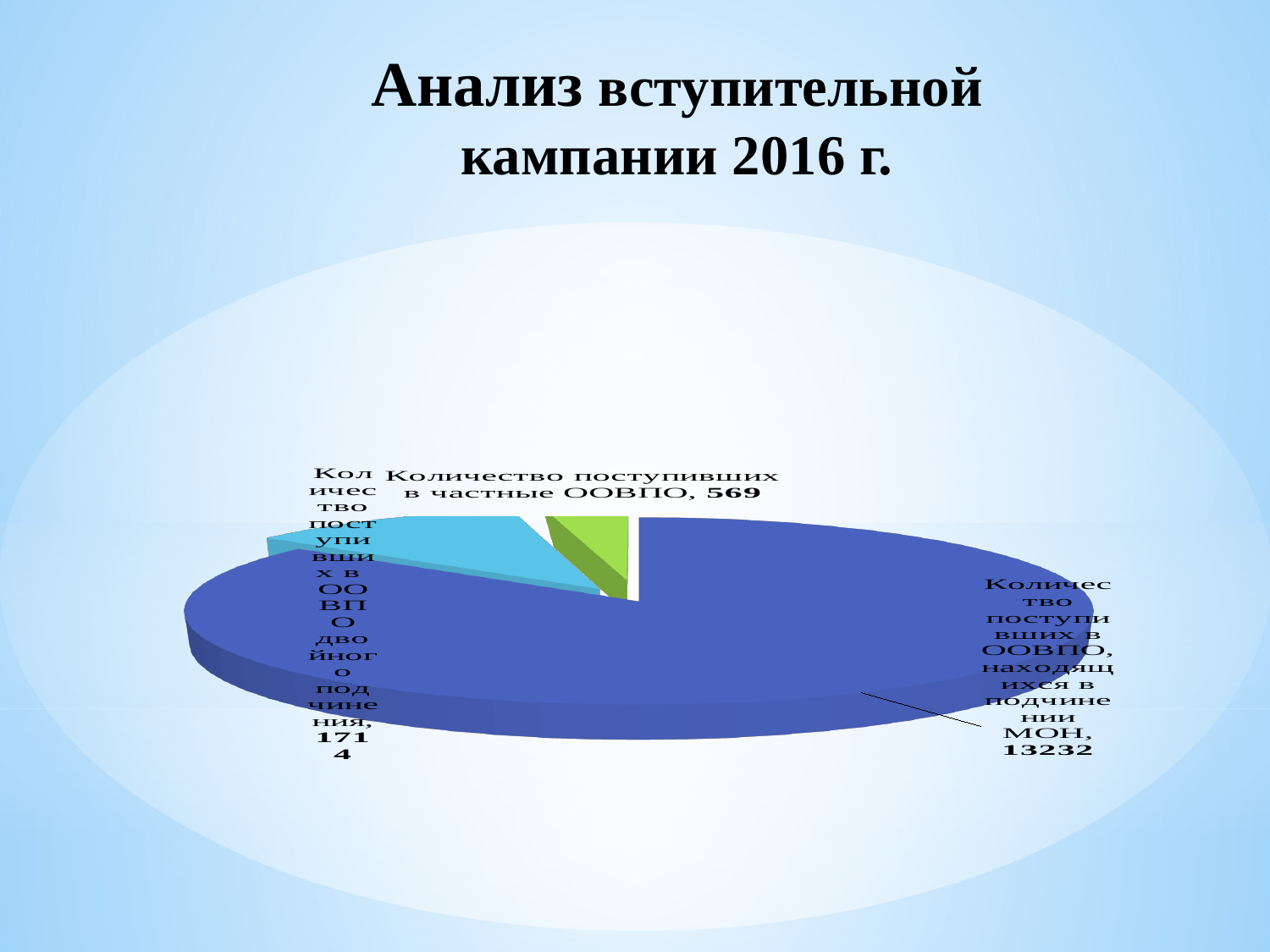
What is the value for "Количество поступивших в ООВПО двойного подчинения"? 1714 What is the title of the slide containing the pie chart? Анализ вступительной кампании 2016 г. Which category has the smallest slice of the pie? Количество поступивших в частные ООВПО Which is larger: the number admitted to ООВПО двойного подчинения or the number admitted to частные ООВПО? Количество поступивших в ООВПО двойного подчинения What is the difference between the number admitted to ООВПО under МОН and the number admitted to ООВПО двойного подчинения? 11518 Which category has the largest slice of the pie? Количество поступивших в ООВПО, находящихся в подчинении МОН What type of chart is shown on the slide? pie chart What is the value for "Количество поступивших в частные ООВПО"? 569 How many slices does the pie chart have? 3 What is the difference between the number admitted to ООВПО двойного подчинения and the number admitted to частные ООВПО? 1145 What is the total of all three slices in the pie chart? 15515 What is the value for "Количество поступивших в ООВПО, находящихся в подчинении МОН"? 13232